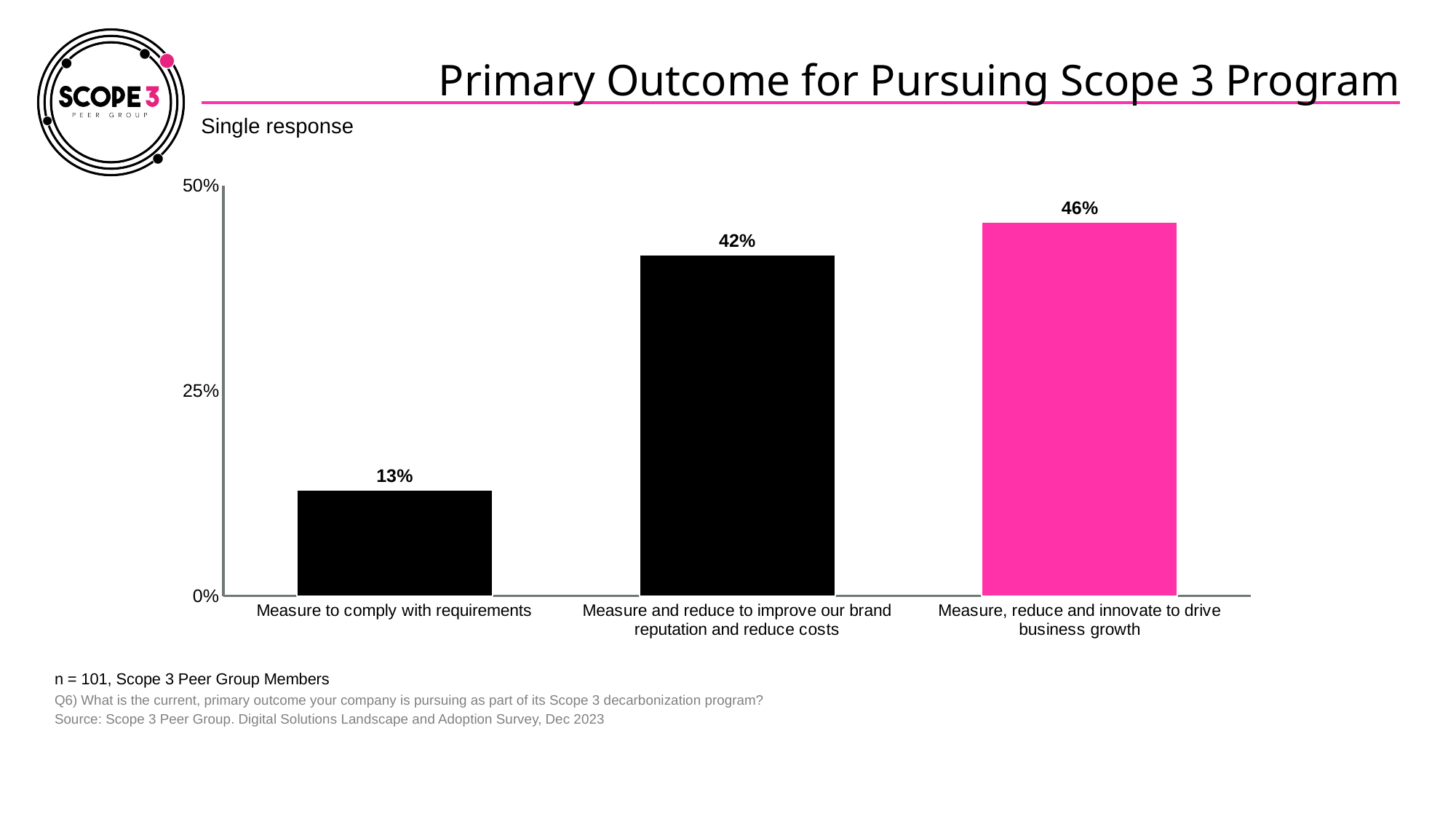
What is the difference in percentage points between "Measure, reduce and innovate to drive business growth" and "Measure to comply with requirements"? 33 percentage points What is the value for "Measure and reduce to improve our brand reputation and reduce costs"? 42% What is the difference between the values for "Measure, reduce and innovate to drive business growth" and "Measure and reduce to improve our brand reputation and reduce costs"? 4 percentage points What type of chart is shown on the slide? Bar chart Which primary outcome has the lowest share of responses? Measure to comply with requirements How many categories are shown on the chart? 3 Which bar on the chart is coloured pink? Measure, reduce and innovate to drive business growth What percentage of respondents chose "Measure to comply with requirements" as their primary outcome? 13% Which primary outcome has the highest share of responses? Measure, reduce and innovate to drive business growth Which is larger: the value for "Measure and reduce to improve our brand reputation and reduce costs" or the value for "Measure to comply with requirements"? Measure and reduce to improve our brand reputation and reduce costs Is the value for "Measure to comply with requirements" greater or less than 25%? less What is the value for "Measure, reduce and innovate to drive business growth"? 46%